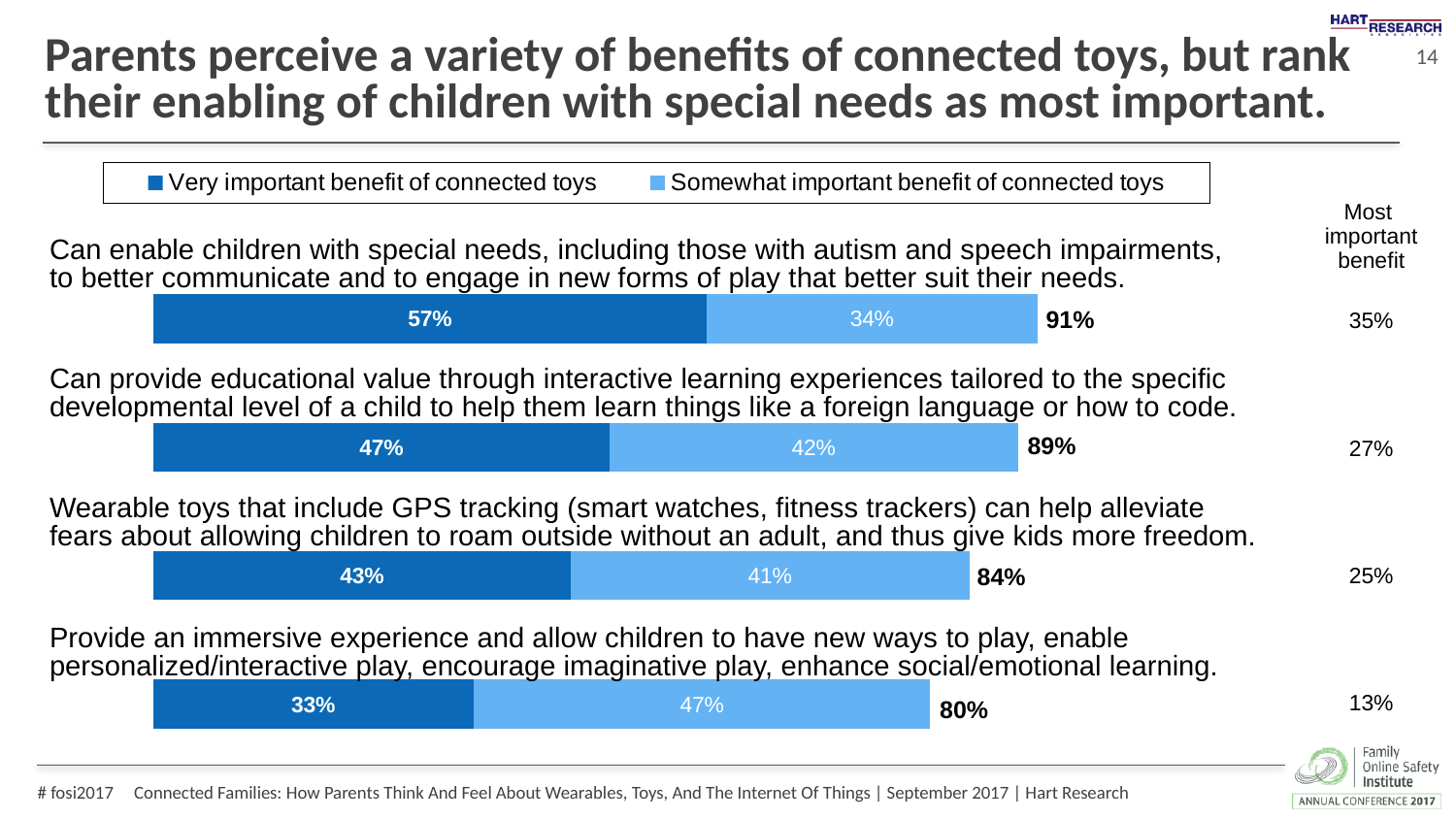
What kind of chart is shown on the slide? Stacked bar chart What is the combined total for the immersive experience benefit? 80% Which benefit has the highest combined total of very and somewhat important? Can enable children with special needs to better communicate and engage in new forms of play What percentage of parents say providing educational value is a somewhat important benefit of connected toys? 42% Which benefit has the lowest share of parents rating it very important? Provide an immersive experience and new ways to play How many series does the legend list? 2 How many benefits (bars) are shown in the chart? 4 What percentage of parents say enabling children with special needs is a very important benefit of connected toys? 57% What is the combined total (very + somewhat important) for wearable toys with GPS tracking? 84% What is the difference between the 'very important' percentages for the special needs benefit and the educational value benefit? 10 percentage points Which is larger: the 'somewhat important' share for the immersive experience benefit or for the GPS tracking wearable toys benefit? Immersive experience (47%) What percentage of parents chose enabling children with special needs as the most important benefit? 35%